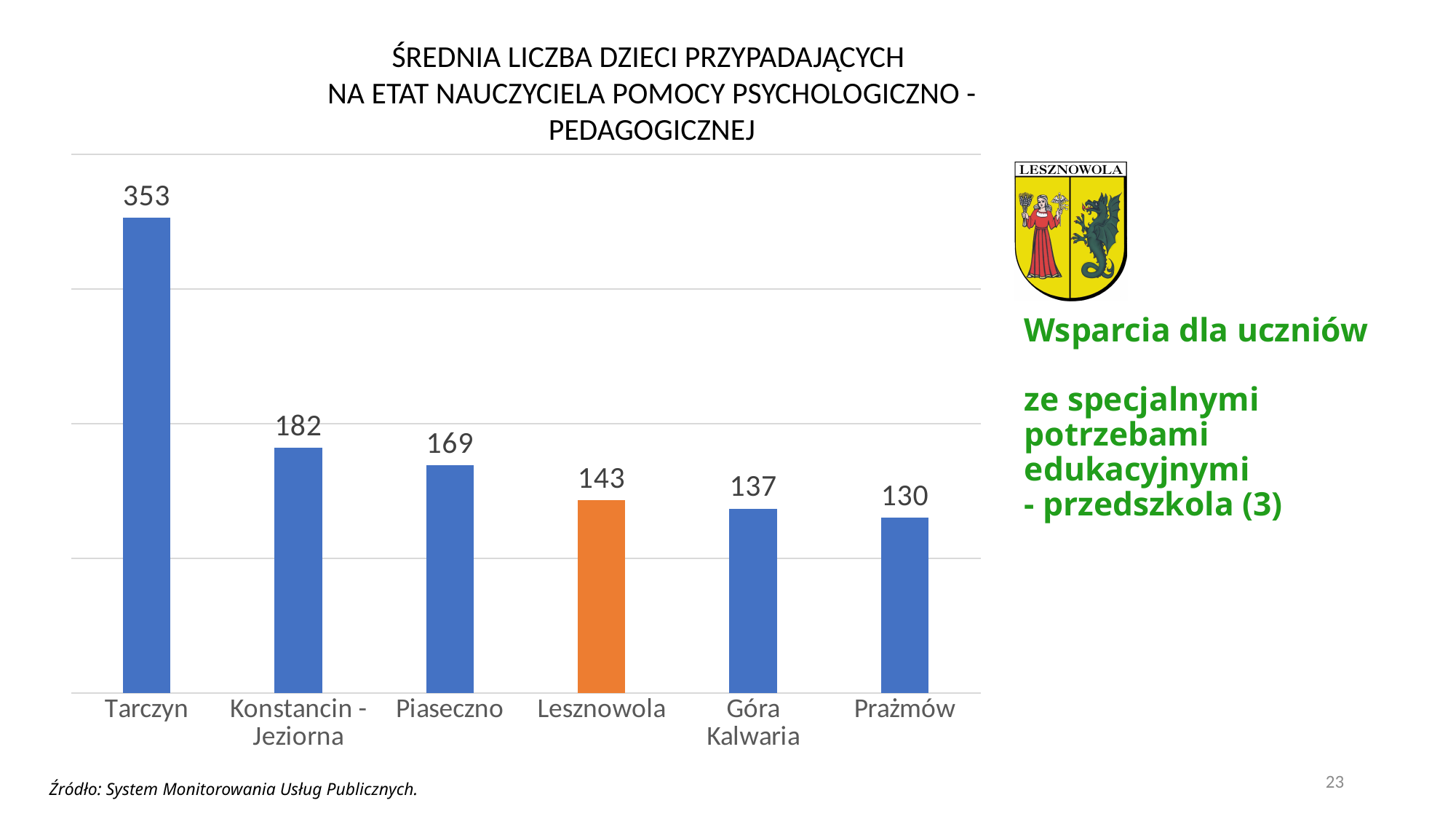
What is the difference between the values for Tarczyn and Konstancin - Jeziorna? 171 What is the value for Tarczyn? 353 What is the difference between the values for Piaseczno and Lesznowola? 26 Which is larger, the value for Konstancin - Jeziorna or the value for Piaseczno? Konstancin - Jeziorna Do the values rise or fall from left to right along the x axis? Fall Which category has the highest value? Tarczyn Which category has the lowest value? Prażmów What kind of chart is shown on the slide? Bar chart What is the value for Lesznowola? 143 Which bar is coloured orange instead of blue? Lesznowola What is the value for Góra Kalwaria? 137 How many categories are shown on the chart? 6